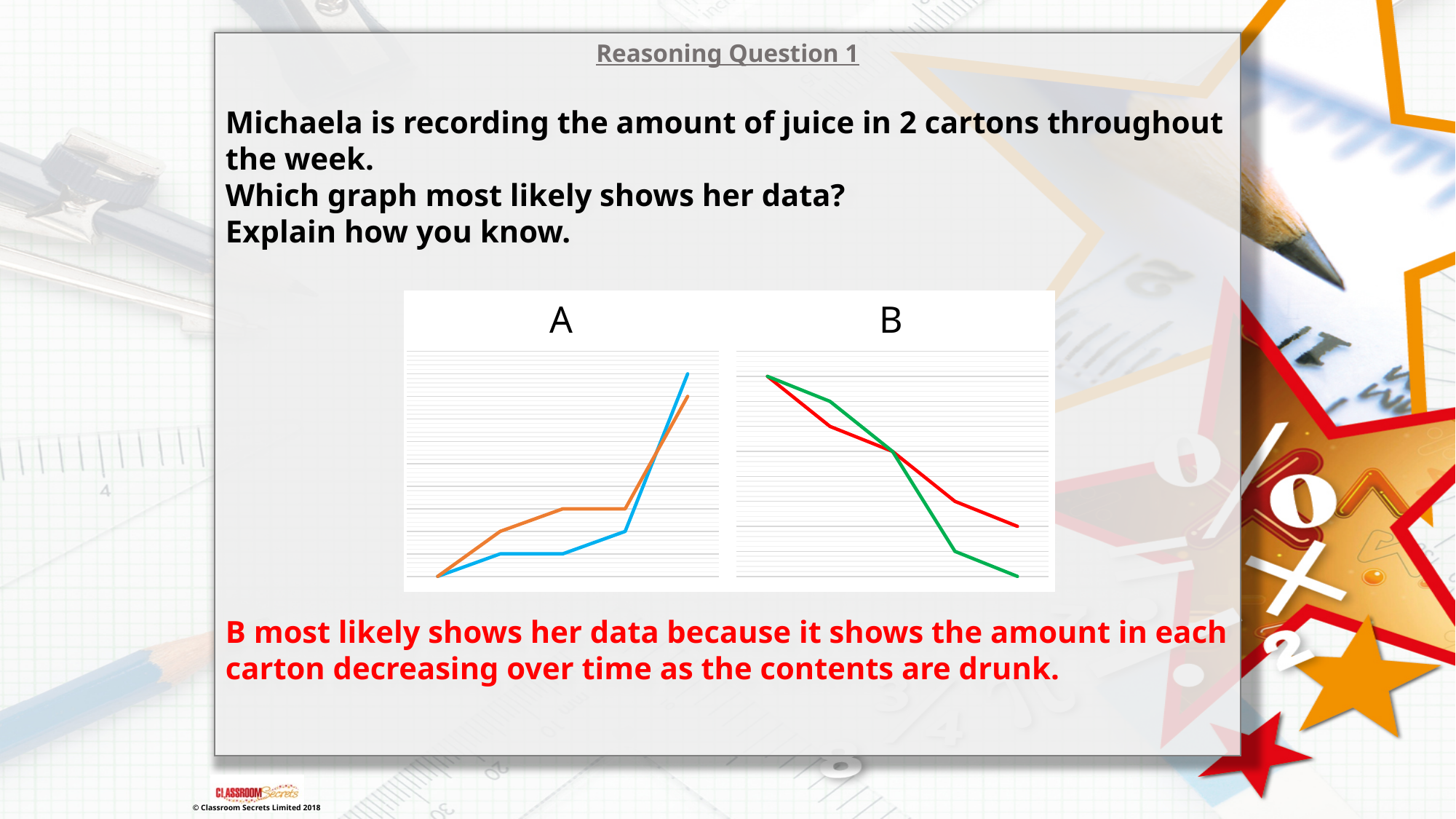
What colours are the two lines in chart B? red and green What kind of chart is chart B? line chart Which chart, A or B, shows the values increasing over time? A In chart B, do the lines rise or fall from left to right? fall How many lines are plotted in chart B? 2 How many lines are plotted in chart A? 2 What colours are the two lines in chart A? blue and orange In chart B, at the right-hand end, which line is higher, the red line or the green line? red Which chart, A or B, shows the values decreasing over time? B In chart A, at the right-hand end, which line is higher, the blue line or the orange line? blue What kind of chart is chart A? line chart